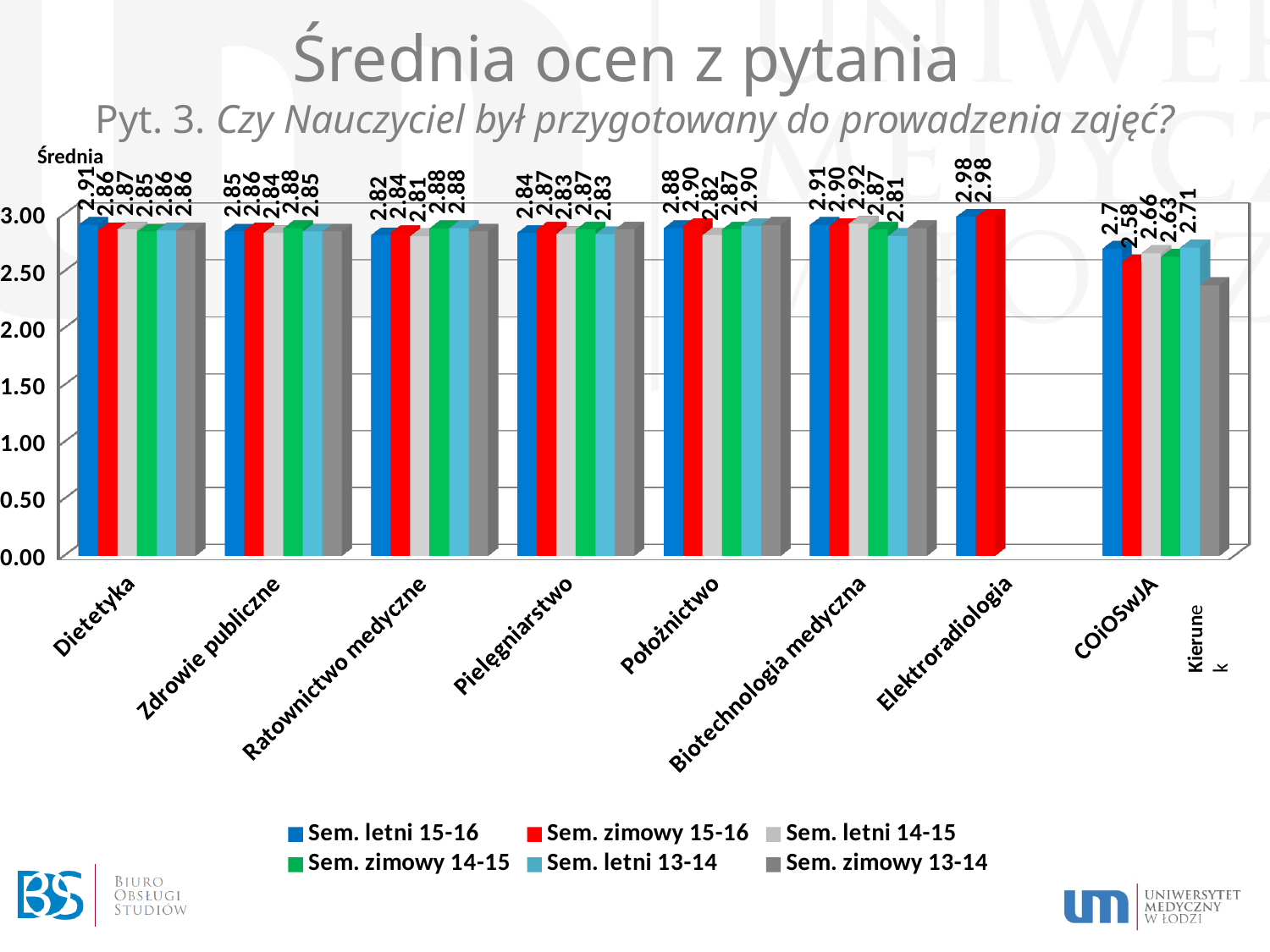
Which category has the highest value in Sem. letni 15-16? Elektroradiologia What is the value for COiOSwJA in Sem. zimowy 15-16? 2.58 Which is larger in Sem. letni 15-16: Dietetyka or Zdrowie publiczne? Dietetyka What is the value for COiOSwJA in Sem. letni 15-16? 2.7 Is the value for COiOSwJA in Sem. zimowy 13-14 greater or less than 2.50? less How many series does the legend list? 6 How many categories (kierunki) are shown on the x axis? 8 Which category has the lowest value in Sem. letni 15-16? COiOSwJA What is the value for Dietetyka in Sem. letni 15-16? 2.91 What kind of chart is shown on the slide? bar chart What is the difference between Elektroradiologia and COiOSwJA in Sem. letni 15-16? 0.28 What is the value for Elektroradiologia in Sem. zimowy 15-16? 2.98